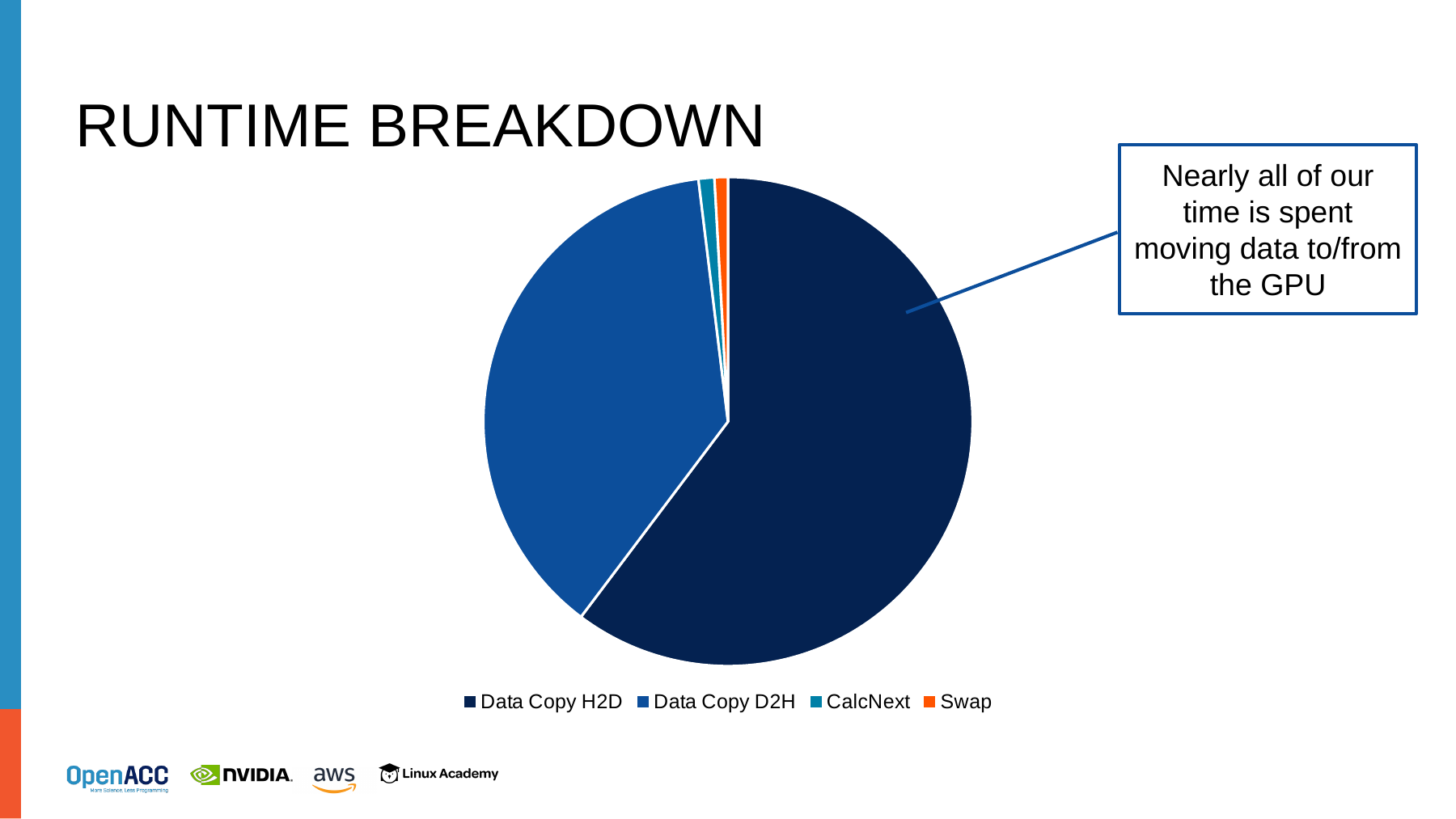
What kind of chart is shown on the slide? pie chart Which slice is larger, Data Copy D2H or CalcNext? Data Copy D2H Which category is shown in orange in the pie chart legend? Swap Which slice is larger, Data Copy H2D or Data Copy D2H? Data Copy H2D What is the title of the slide containing the pie chart? RUNTIME BREAKDOWN Which category takes up the largest share of the pie chart? Data Copy H2D Which slice is larger, Data Copy H2D or Swap? Data Copy H2D How many slices does the pie chart have? 4 How many entries does the legend of the pie chart list? 4